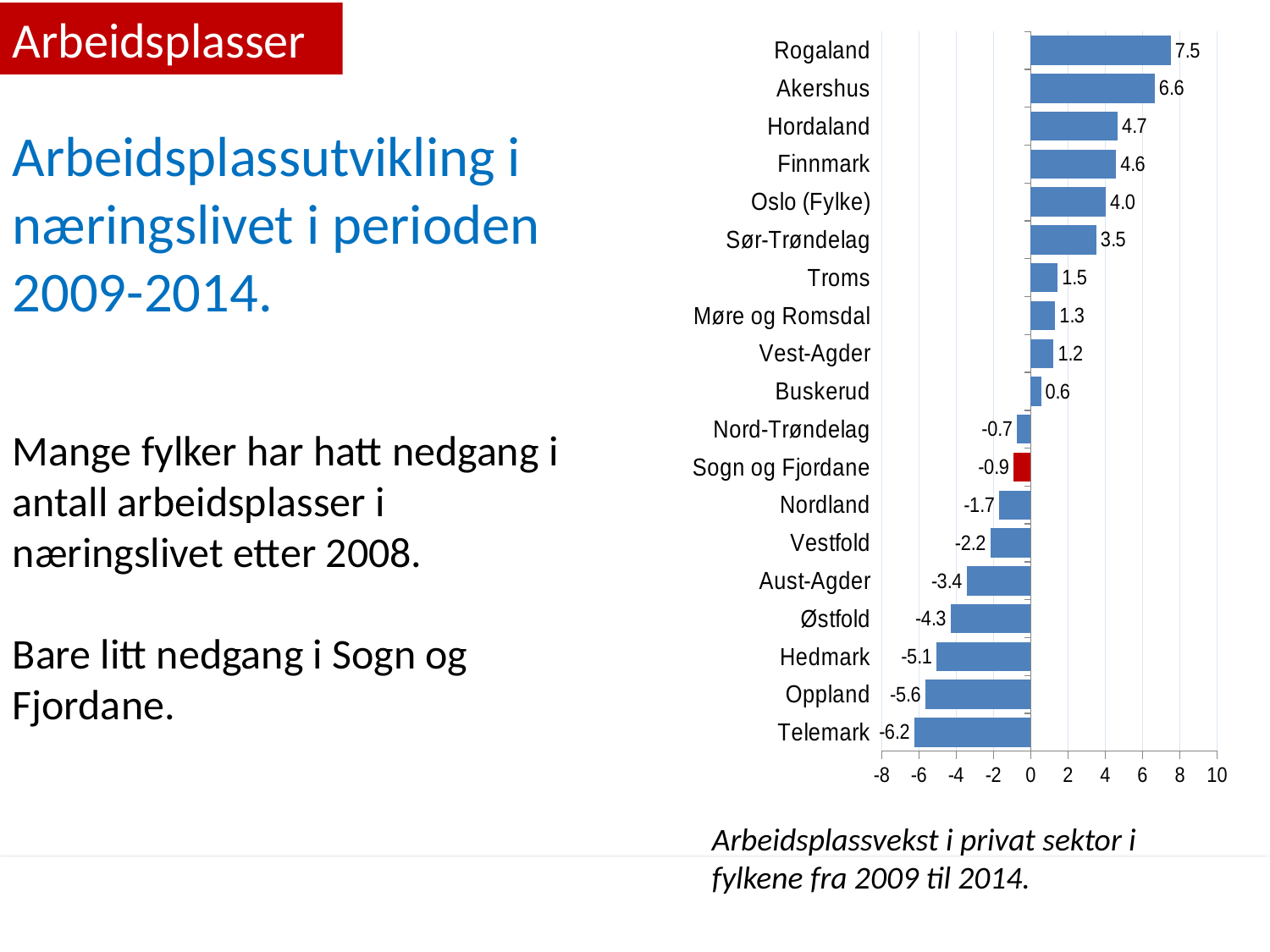
What is the difference between the values for Rogaland and Akershus? 0.9 What type of chart is shown on the slide? Bar chart What is the value for Telemark? -6.2 How many counties are shown in the chart? 19 What is the difference between the values for Hordaland and Finnmark? 0.1 Which county has the highest value? Rogaland What is the value for Oslo (Fylke)? 4.0 Which county's bar is coloured red instead of blue? Sogn og Fjordane What is the value for Rogaland? 7.5 Which has a larger value, Troms or Buskerud? Troms What is the value for Sogn og Fjordane? -0.9 Which county has the lowest value? Telemark